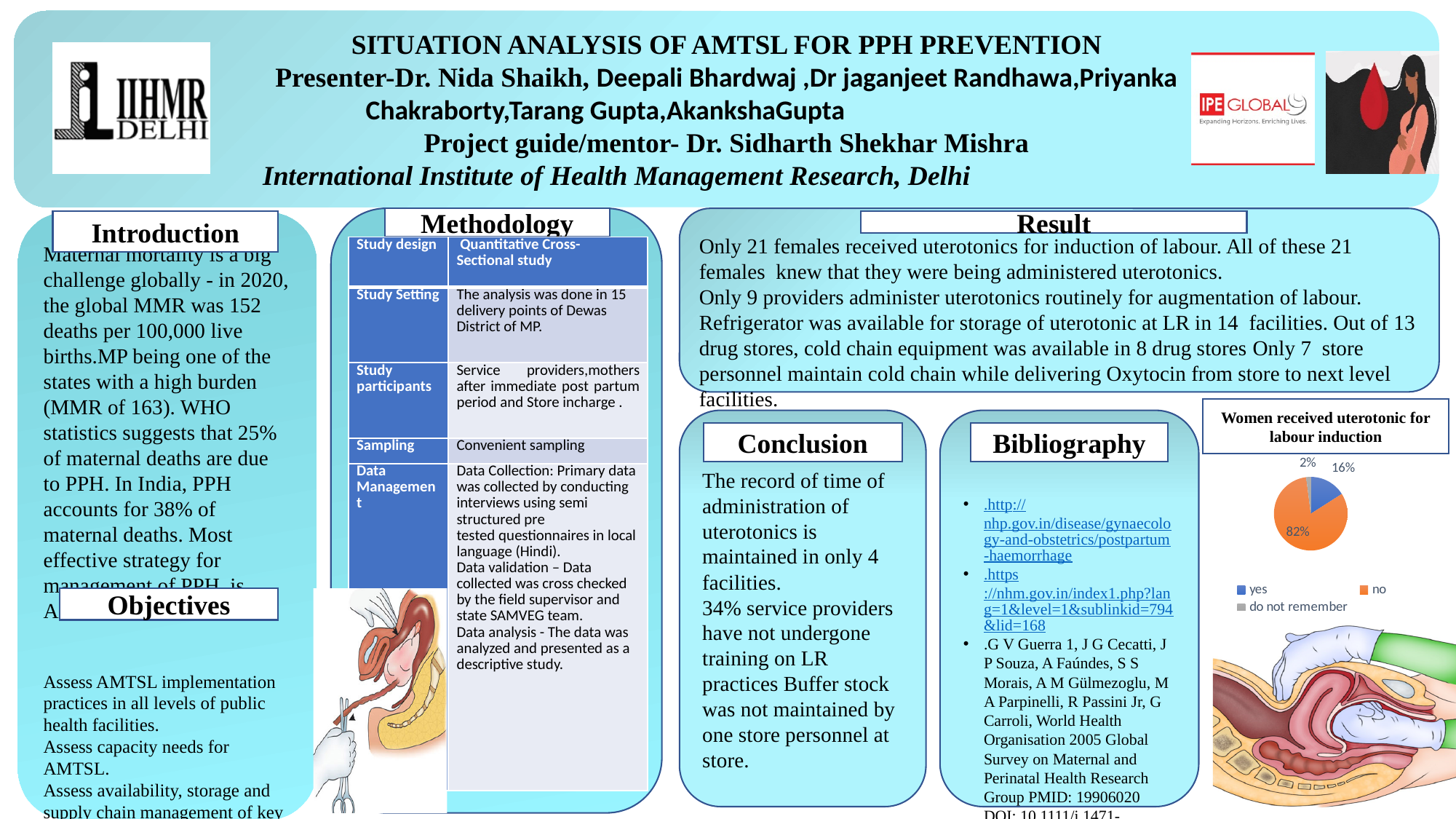
In the pie chart, which is larger: the "yes" slice or the "no" slice? no What colour is the "no" slice in the pie chart? orange Which category has the largest slice in the pie chart? no How many categories does the legend of the pie chart list? 3 In the pie chart, what share of women answered "no" to receiving uterotonic for labour induction? 82% In the pie chart, what share of women answered "yes"? 16% What kind of chart is shown under the title "Women received uterotonic for labour induction"? pie chart In the pie chart, what share of women answered "do not remember"? 2% What is the title of the pie chart on the slide? Women received uterotonic for labour induction What is the difference in percentage points between the "no" slice and the "yes" slice in the pie chart? 66 How many slices does the pie chart have? 3 Which category has the smallest slice in the pie chart? do not remember